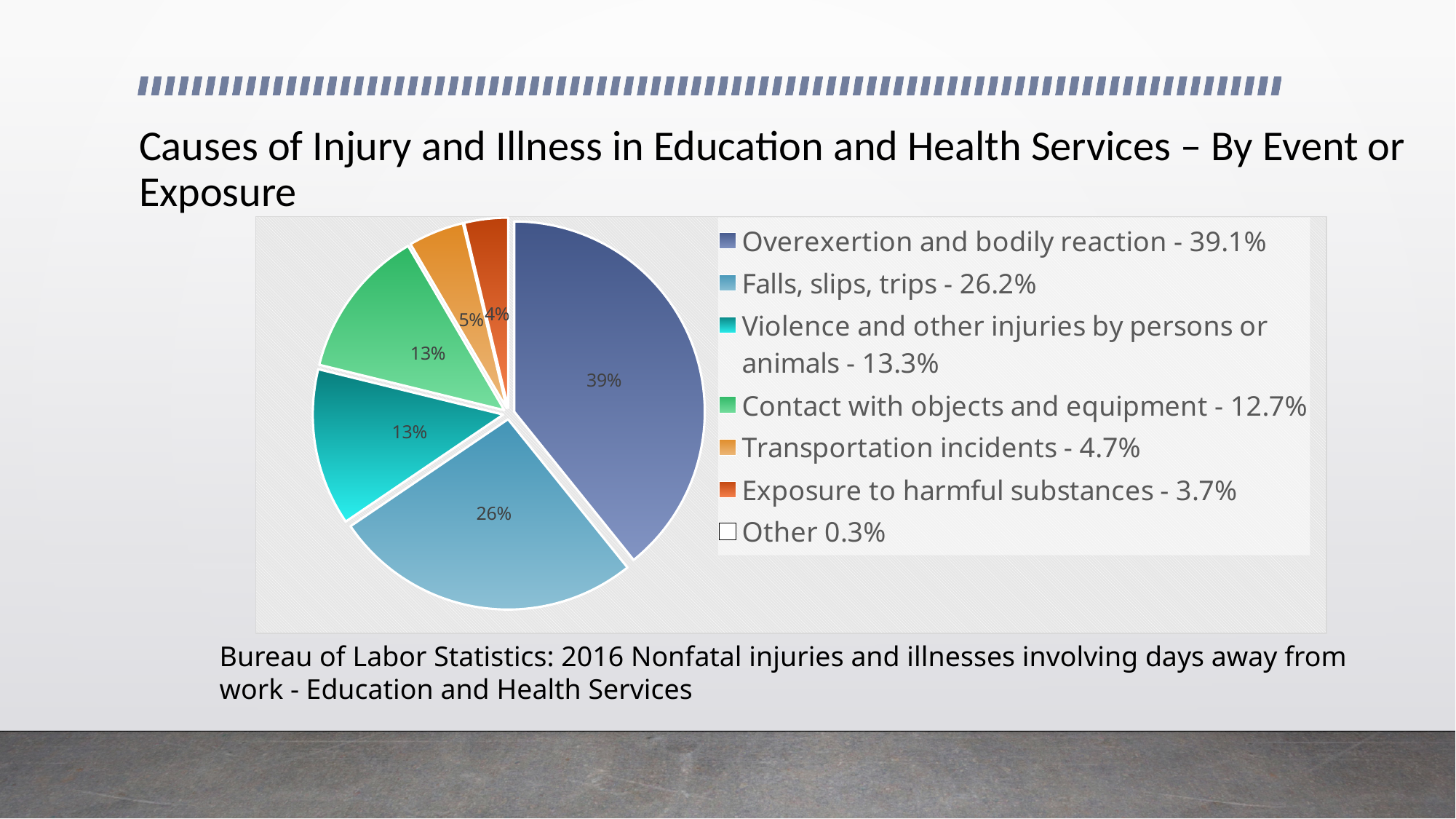
According to the legend, what percentage is attributed to Falls, slips, trips? 26.2% According to the legend, what percentage is attributed to Transportation incidents? 4.7% According to the legend, what percentage is attributed to Overexertion and bodily reaction? 39.1% Using the legend values, what is the difference between Overexertion and bodily reaction and Falls, slips, trips? 12.9% How many categories does the legend list? 7 What data label is printed on the Falls, slips, trips slice of the pie? 26% Which is larger according to the legend: Violence and other injuries by persons or animals, or Contact with objects and equipment? Violence and other injuries by persons or animals Which cause accounts for the largest share of the pie? Overexertion and bodily reaction Which cause accounts for the smallest share of the pie? Other What kind of chart is shown on the slide? pie chart According to the legend, what percentage is attributed to Exposure to harmful substances? 3.7% What is the title of the slide containing the chart? Causes of Injury and Illness in Education and Health Services – By Event or Exposure